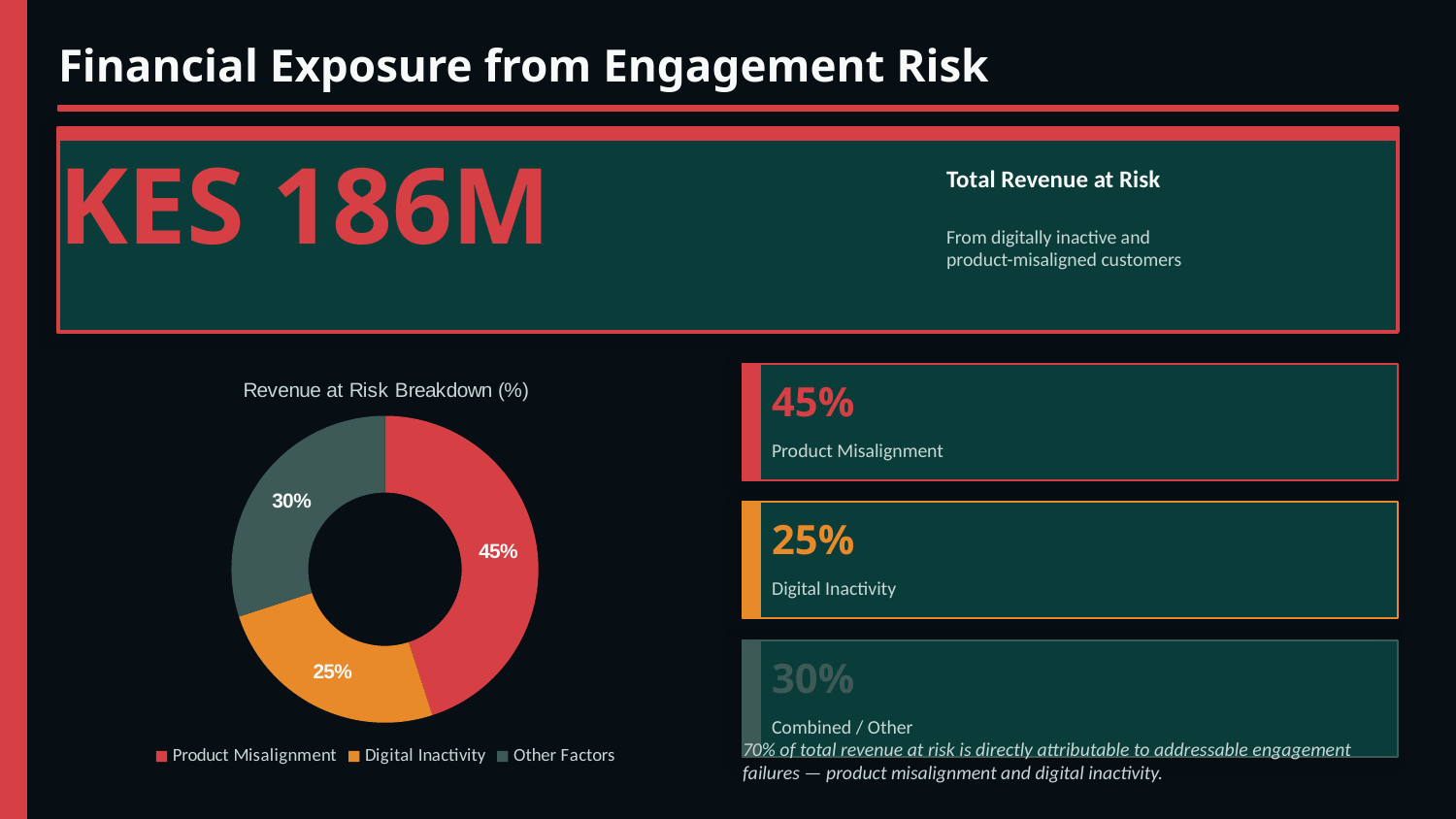
Which category has the largest share in the chart? Product Misalignment What share of the chart does Other Factors represent? 30% What colour represents Digital Inactivity in the chart? Orange Which is larger, the share for Other Factors or the share for Digital Inactivity? Other Factors What kind of chart is shown on the slide? Pie chart (doughnut) What is the difference between the shares of Product Misalignment and Digital Inactivity? 20% What is the combined share of Product Misalignment and Digital Inactivity? 70% Which category has the smallest share in the chart? Digital Inactivity What share of the chart does Product Misalignment represent? 45% What share of the chart does Digital Inactivity represent? 25% What is the title of the chart? Revenue at Risk Breakdown (%) How many categories are shown in the chart? 3